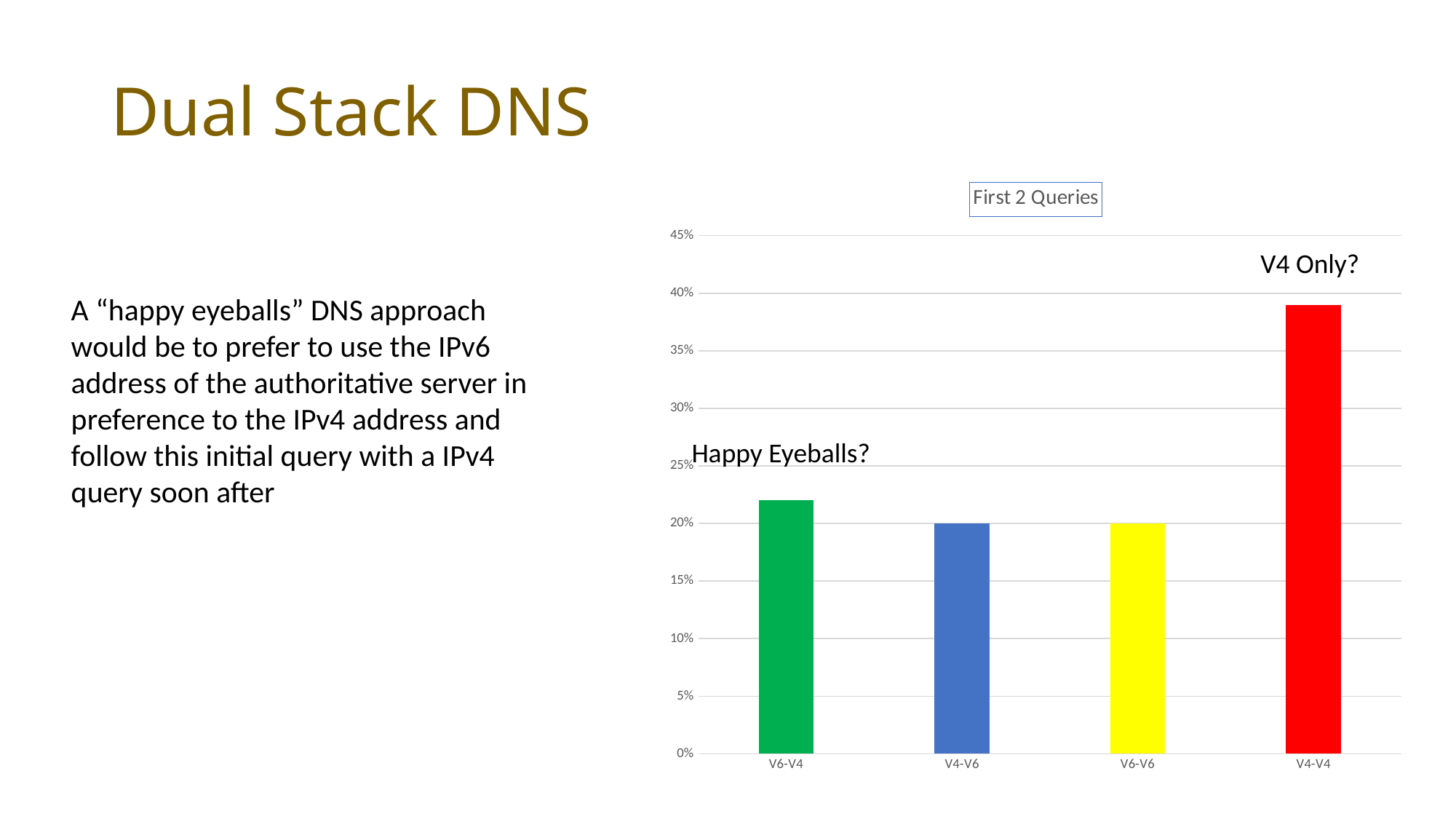
Which is larger, the value for V4-V4 or the value for V6-V4? V4-V4 Is the value for V4-V4 greater or less than 35%? greater What kind of chart is shown on the slide? bar chart What colour is the bar for V4-V4? red Is the value for V6-V4 greater or less than 20%? greater What is the value for V6-V6? 20% Which category has the highest value in the chart? V4-V4 What is the title of the chart? First 2 Queries Which is larger, the value for V6-V4 or the value for V4-V6? V6-V4 How many categories are plotted on the x axis of the chart? 4 What is the value for V4-V6? 20% Is the value for V4-V4 greater or less than 40%? less